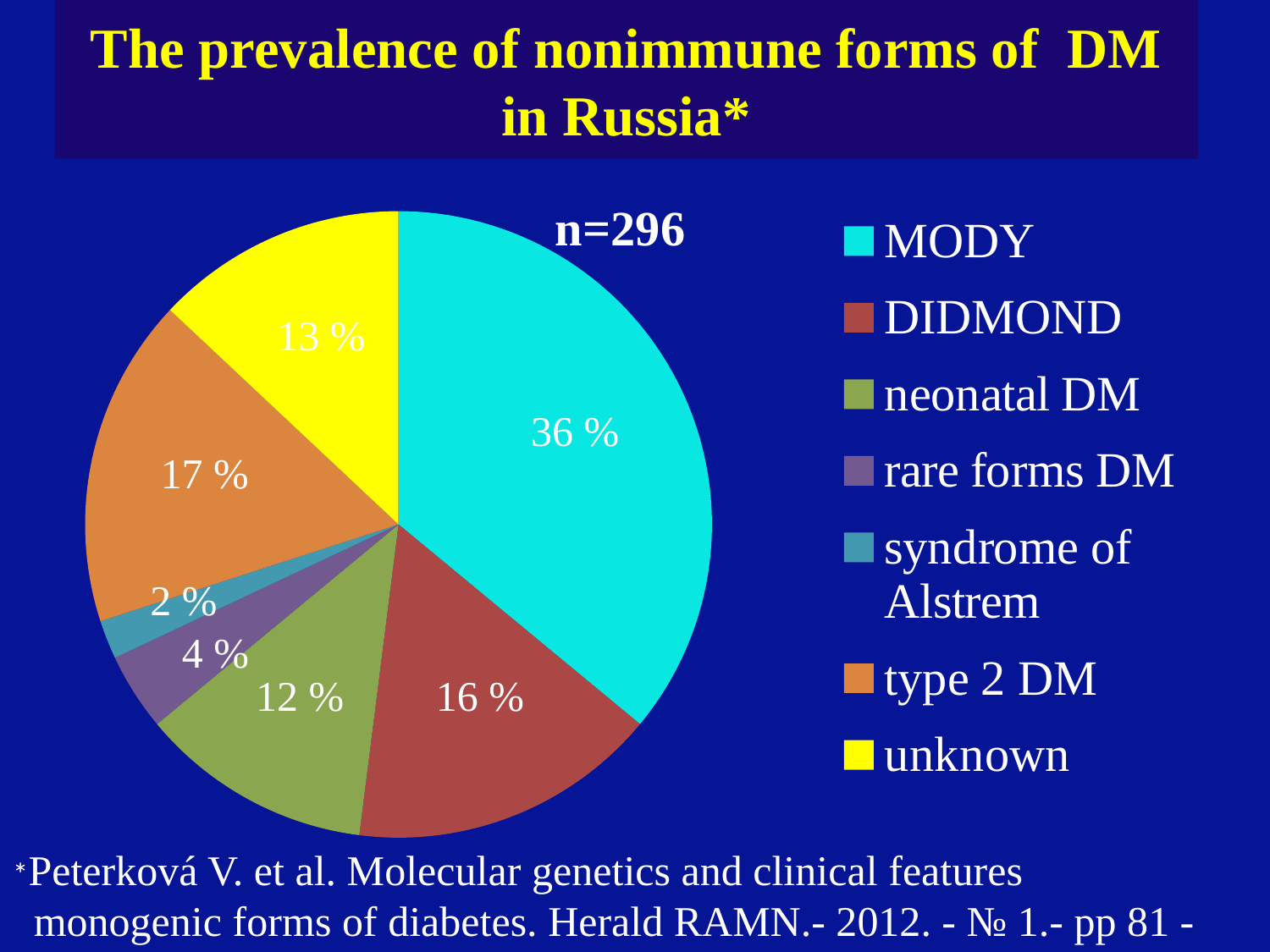
What percentage is shown for syndrome of Alstrem? 2 % How many categories does the legend list? 7 Which category has the smallest slice of the pie? syndrome of Alstrem What is the difference in percentage points between type 2 DM and unknown? 4 What sample size (n) is printed next to the pie chart? n=296 Which is larger, the share for DIDMOND or the share for neonatal DM? DIDMOND What share of the pie does MODY account for? 36 % What kind of chart is shown on the slide? pie chart Which category has the largest slice of the pie? MODY What is the difference in percentage points between MODY and DIDMOND? 20 What percentage is shown for type 2 DM? 17 % What percentage is shown for neonatal DM? 12 %